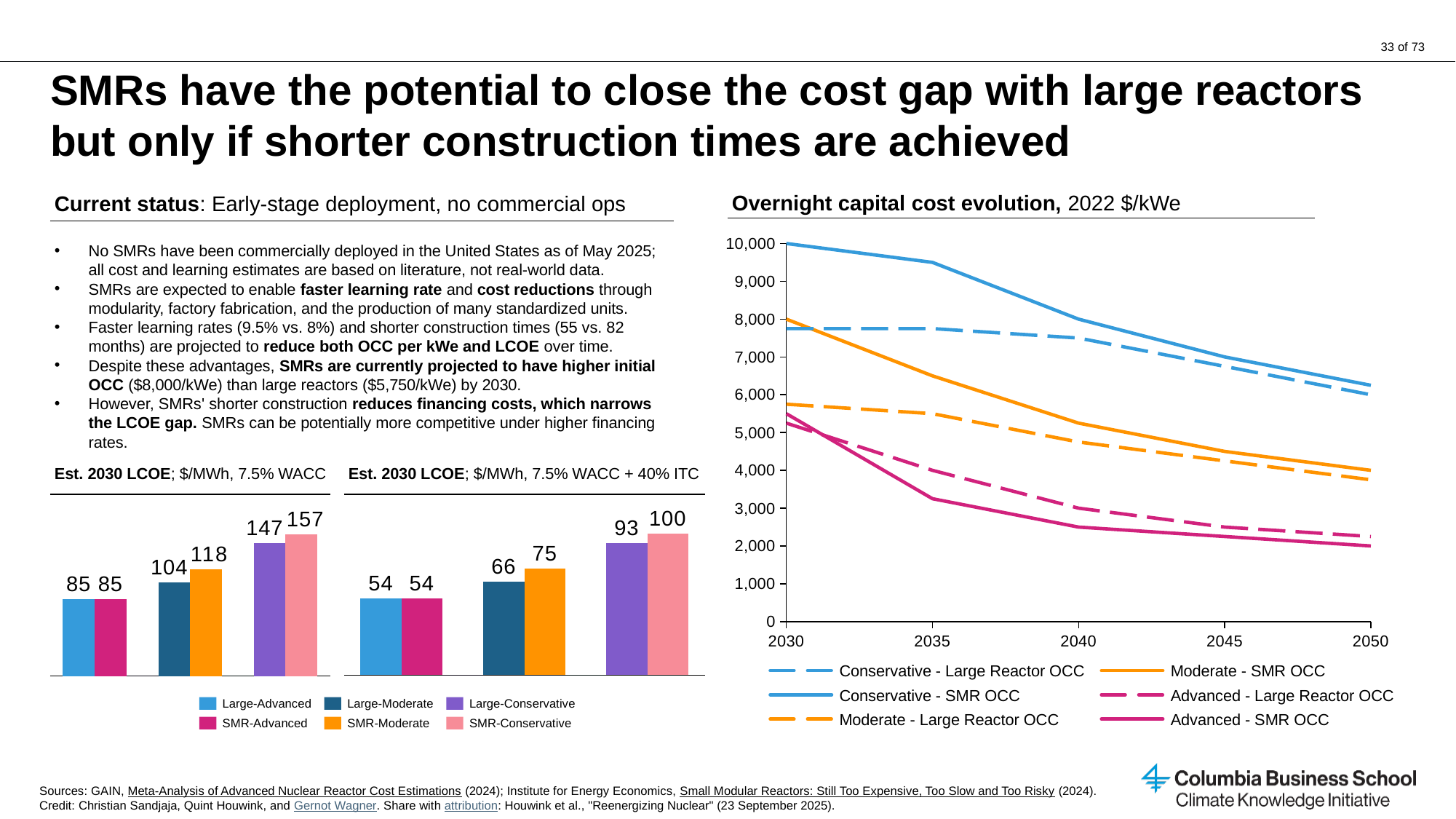
In the 'Est. 2030 LCOE; $/MWh, 7.5% WACC' chart, what is the value for Large-Moderate? 104 In the 'Overnight capital cost evolution' chart, what is the value of Conservative - SMR OCC in 2030? 10,000 In the 'Overnight capital cost evolution' chart, is the value of Moderate - SMR OCC in 2040 greater or less than 6,000? less In the 'Est. 2030 LCOE; $/MWh, 7.5% WACC + 40% ITC' chart, what is the value for SMR-Conservative? 100 How many series does the legend of the 'Overnight capital cost evolution' chart list? 6 In the 'Est. 2030 LCOE; $/MWh, 7.5% WACC + 40% ITC' chart, which is larger, Large-Conservative or SMR-Conservative? SMR-Conservative What kind of chart is the 'Overnight capital cost evolution' chart? Line chart In the 'Est. 2030 LCOE; $/MWh, 7.5% WACC' chart, what is the value for SMR-Conservative? 157 In the 'Est. 2030 LCOE; $/MWh, 7.5% WACC' chart, what is the difference between SMR-Moderate and Large-Moderate? 14 In the 'Overnight capital cost evolution' chart, does Advanced - SMR OCC rise or fall from 2030 to 2050? Fall In the 'Est. 2030 LCOE; $/MWh, 7.5% WACC + 40% ITC' chart, which bar is the highest? SMR-Conservative In the 'Est. 2030 LCOE; $/MWh, 7.5% WACC + 40% ITC' chart, what is the difference between SMR-Moderate and Large-Moderate? 9